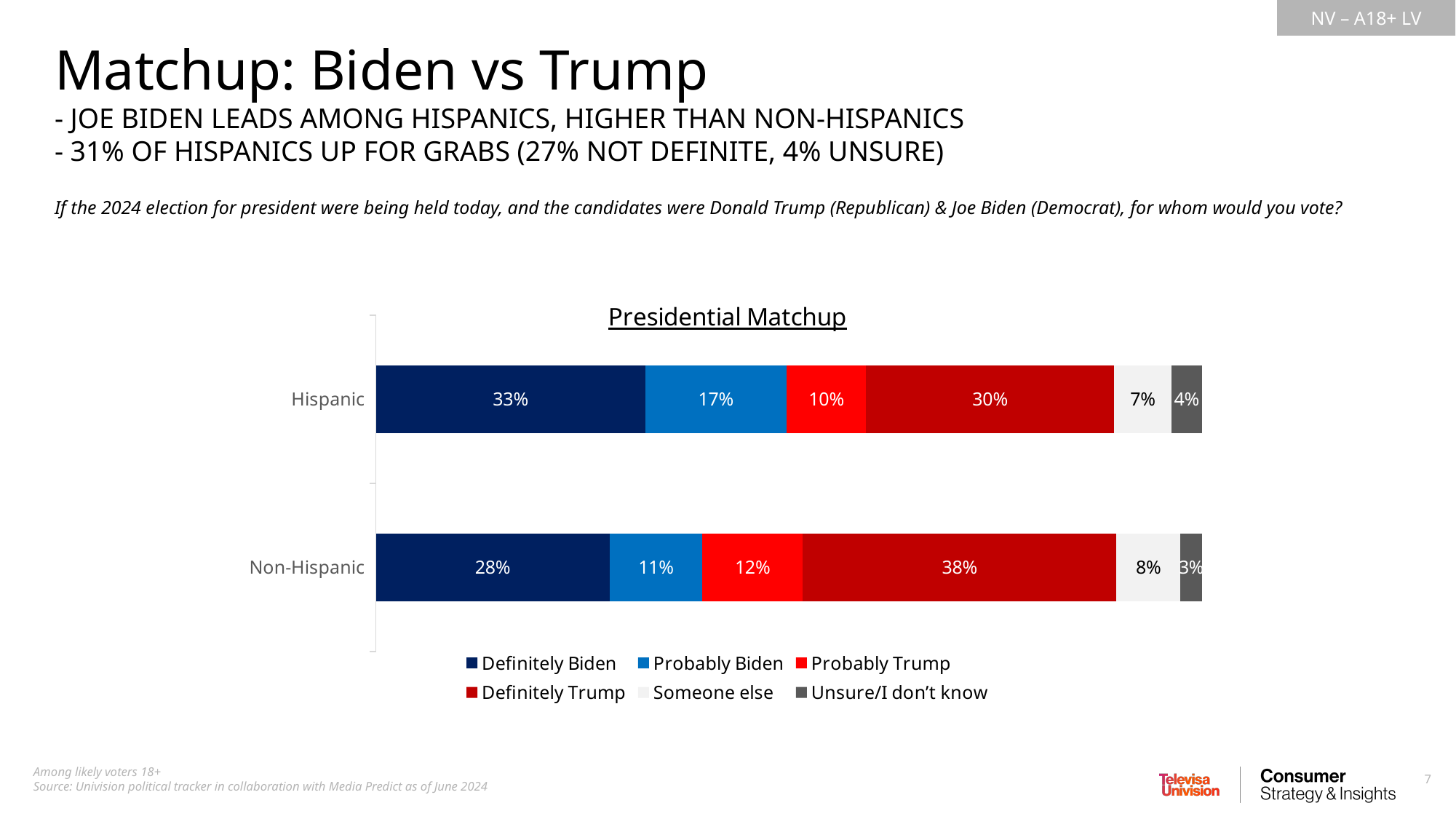
What is the title of the chart? Presidential Matchup How many categories (bars) are shown in the chart? 2 Which segment is the smallest in the Hispanic bar? Unsure/I don't know Which group has a higher Probably Trump value, Hispanic or Non-Hispanic? Non-Hispanic What percentage of Non-Hispanic likely voters said Definitely Trump? 38% What is the difference between the Definitely Trump values for Non-Hispanic and Hispanic voters? 8% Which segment is the largest in the Non-Hispanic bar? Definitely Trump How many series does the legend list? 6 What percentage of Hispanic likely voters said Definitely Biden? 33% What is the Someone else value for the Hispanic bar? 7% What kind of chart is shown on the slide? Stacked bar chart What is the Probably Biden value for the Non-Hispanic bar? 11%